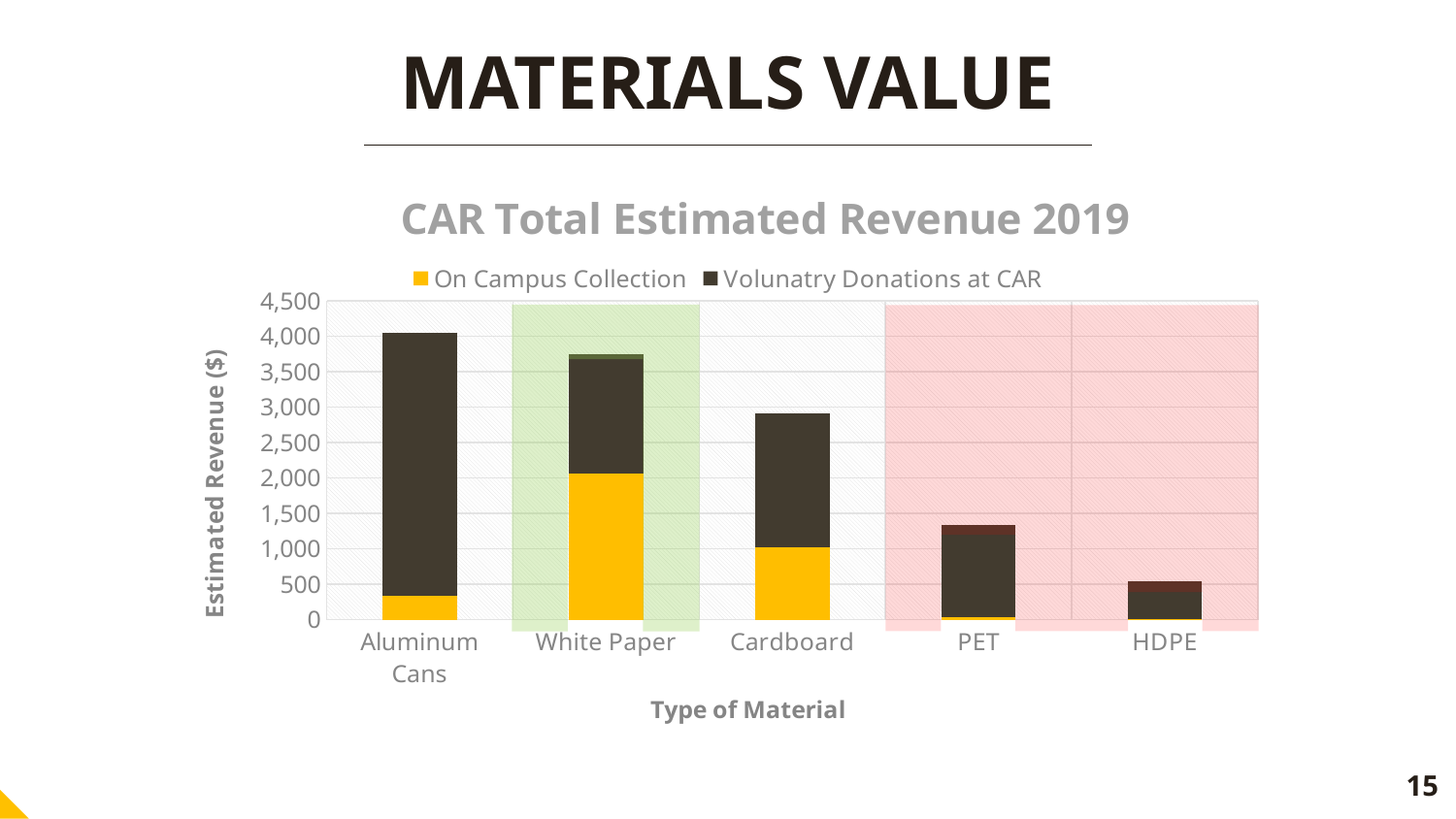
Which type of material has the largest On Campus Collection value? White Paper Which has a larger total estimated revenue, Cardboard or PET? Cardboard Which type of material has the highest total estimated revenue? Aluminum Cans Do the total estimated revenues rise or fall moving from Aluminum Cans to HDPE along the x axis? fall Is the On Campus Collection value for White Paper greater or less than 1,500? greater Is the total estimated revenue for HDPE greater or less than 1,000? less Is the total estimated revenue for Aluminum Cans greater or less than 3,500? greater How many series does the legend list? 2 How many types of material are shown on the x axis? 5 What kind of chart is shown on the slide? Stacked bar chart Which type of material has the lowest total estimated revenue? HDPE What is the title of the chart? CAR Total Estimated Revenue 2019